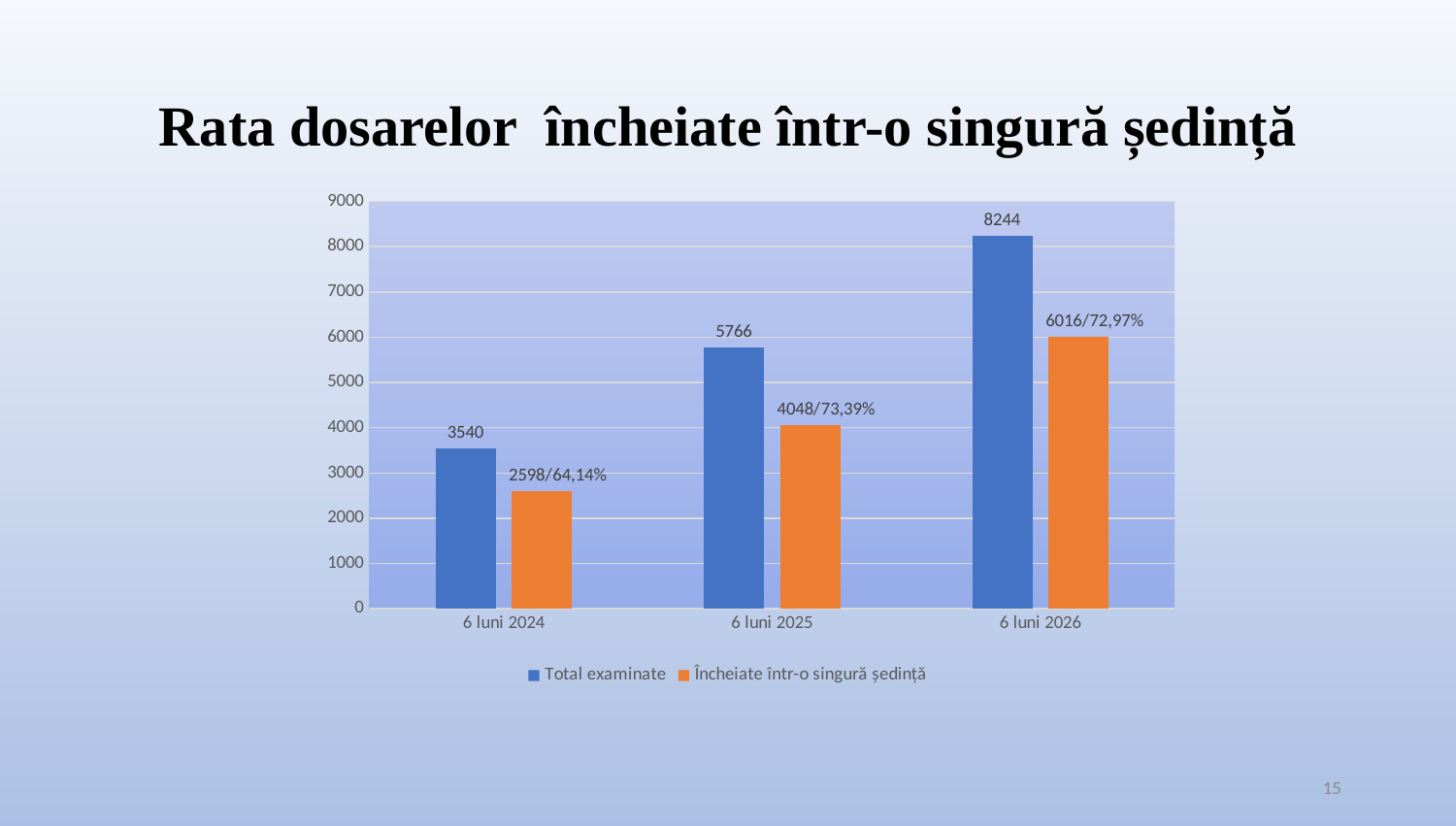
What is the data label on the Încheiate într-o singură ședință bar for 6 luni 2025? 4048/73,39% What is the data label on the Încheiate într-o singură ședință bar for 6 luni 2024? 2598/64,14% How many series does the legend list? 2 What is the difference between Total examinate for 6 luni 2026 and 6 luni 2025? 2478 What kind of chart is shown on the slide? Bar chart Which period has the lowest Încheiate într-o singură ședință value? 6 luni 2024 What is the value of Total examinate for 6 luni 2024? 3540 Which is larger: Total examinate for 6 luni 2025 or Încheiate într-o singură ședință for 6 luni 2026? Încheiate într-o singură ședință for 6 luni 2026 What is the value of Total examinate for 6 luni 2026? 8244 How many periods are shown on the x axis? 3 Do the Total examinate values rise or fall from 6 luni 2024 to 6 luni 2026? Rise Which period has the highest Total examinate value? 6 luni 2026